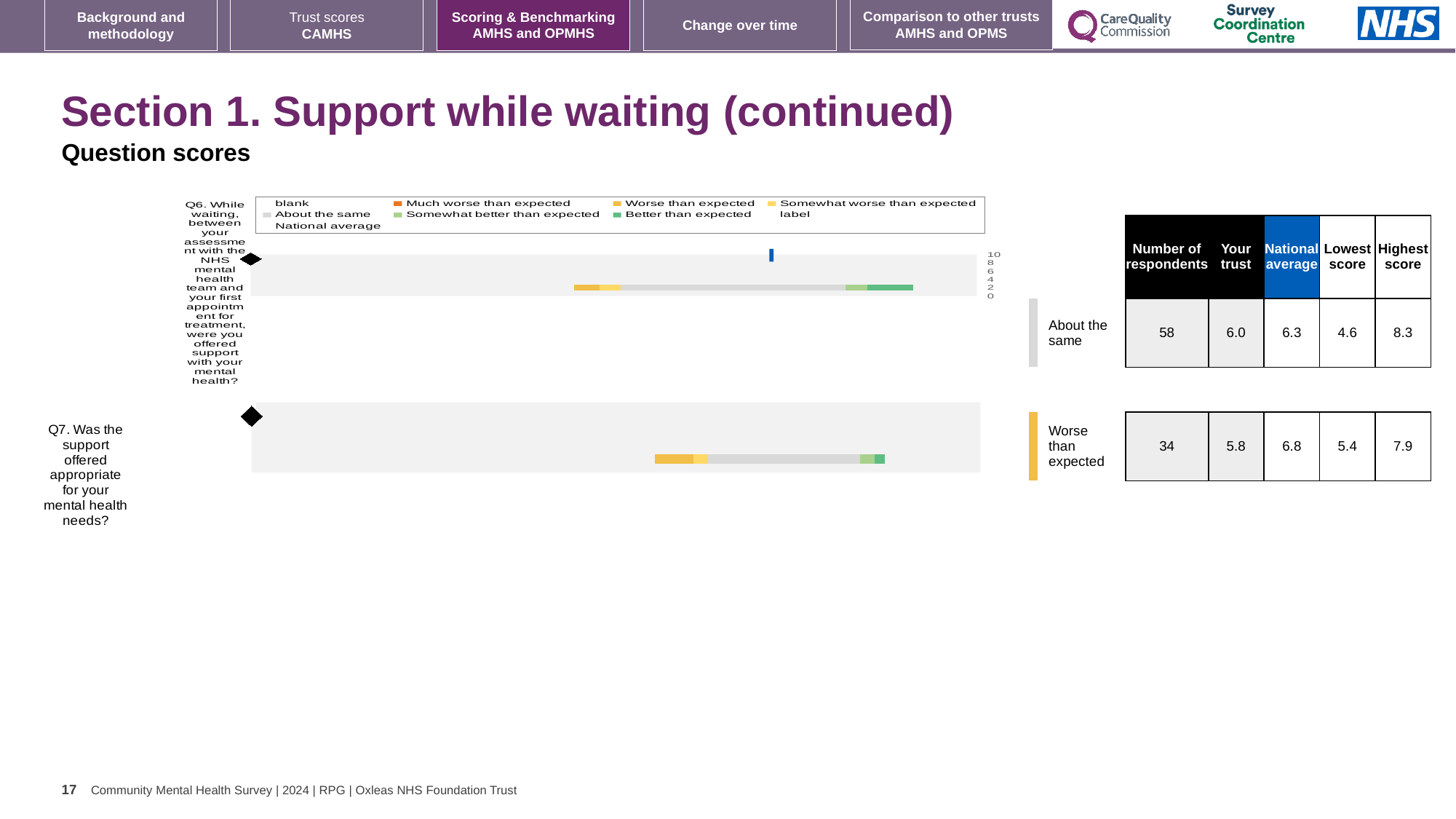
For Q6, which is larger: the 'Your trust' score or the national average? National average For Q7, what is the difference between the highest score (7.9) and the lowest score (5.4)? 2.5 For Q7 (was the support offered appropriate), what is the highest score? 7.9 In the chart legend, which entry is shown in orange? Much worse than expected For Q7 (was the support offered appropriate), how many respondents are there? 34 For Q6, what is the difference between the national average (6.3) and the 'Your trust' score (6.0)? 0.3 For Q6 (support while waiting), what is the national average score? 6.3 What benchmark category is Q7 (was the support offered appropriate) assigned? Worse than expected In the chart legend, which entry is shown in dark green? Better than expected How many questions (Q6 and Q7) are plotted on the slide? 2 What kind of chart is used to show the Q6 and Q7 question scores? bar chart For Q6 (support while waiting), what is the 'Your trust' score? 6.0